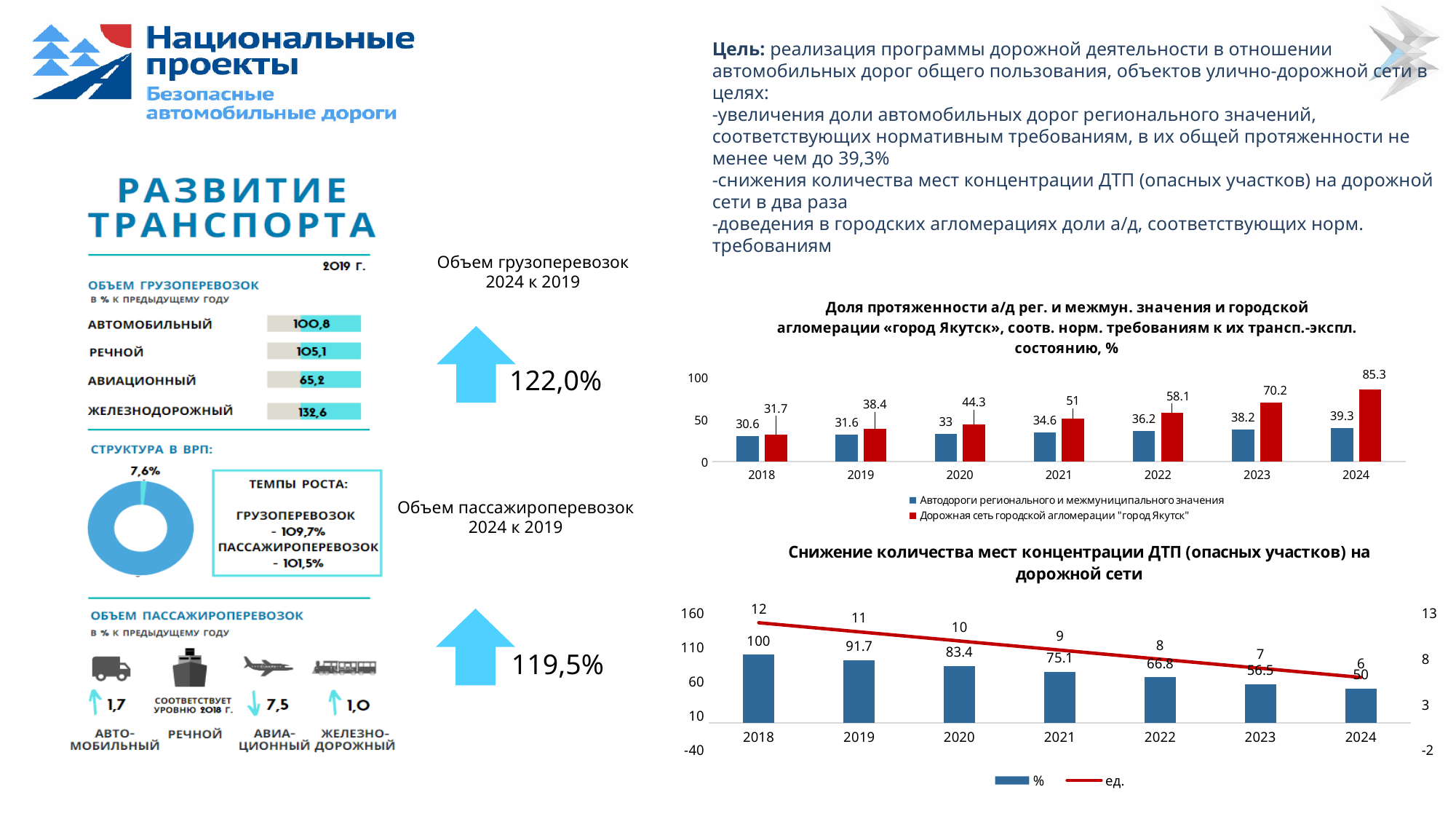
In the top chart (Доля протяженности а/д...), what is the value for Дорожная сеть городской агломерации "город Якутск" in 2024? 85.3 In the top chart (Доля протяженности а/д...), what is the value for Автодороги регионального и межмуниципального значения in 2018? 30.6 In the top chart (Доля протяженности а/д...), what is the difference between the two series in 2023? 32 In the top chart (Доля протяженности а/д...), in which year is the value for Дорожная сеть городской агломерации "город Якутск" the lowest? 2018 In the top chart (Доля протяженности а/д...), do the values for Автодороги регионального и межмуниципального значения rise or fall from 2018 to 2024? rise In the bottom chart (Снижение количества мест концентрации ДТП...), what is the % value for 2021? 75.1 In the bottom chart (Снижение количества мест концентрации ДТП...), do the ед. values rise or fall from 2018 to 2024? fall In the bottom chart (Снижение количества мест концентрации ДТП...), how many years are shown on the x axis? 7 In the bottom chart (Снижение количества мест концентрации ДТП...), what is the ед. value for 2024? 6 In the top chart (Доля протяженности а/д...), how many series does the legend list? 2 What kind of chart is the top chart (Доля протяженности а/д...)? bar chart In the bottom chart (Снижение количества мест концентрации ДТП...), what is the difference between the % values for 2018 and 2024? 50